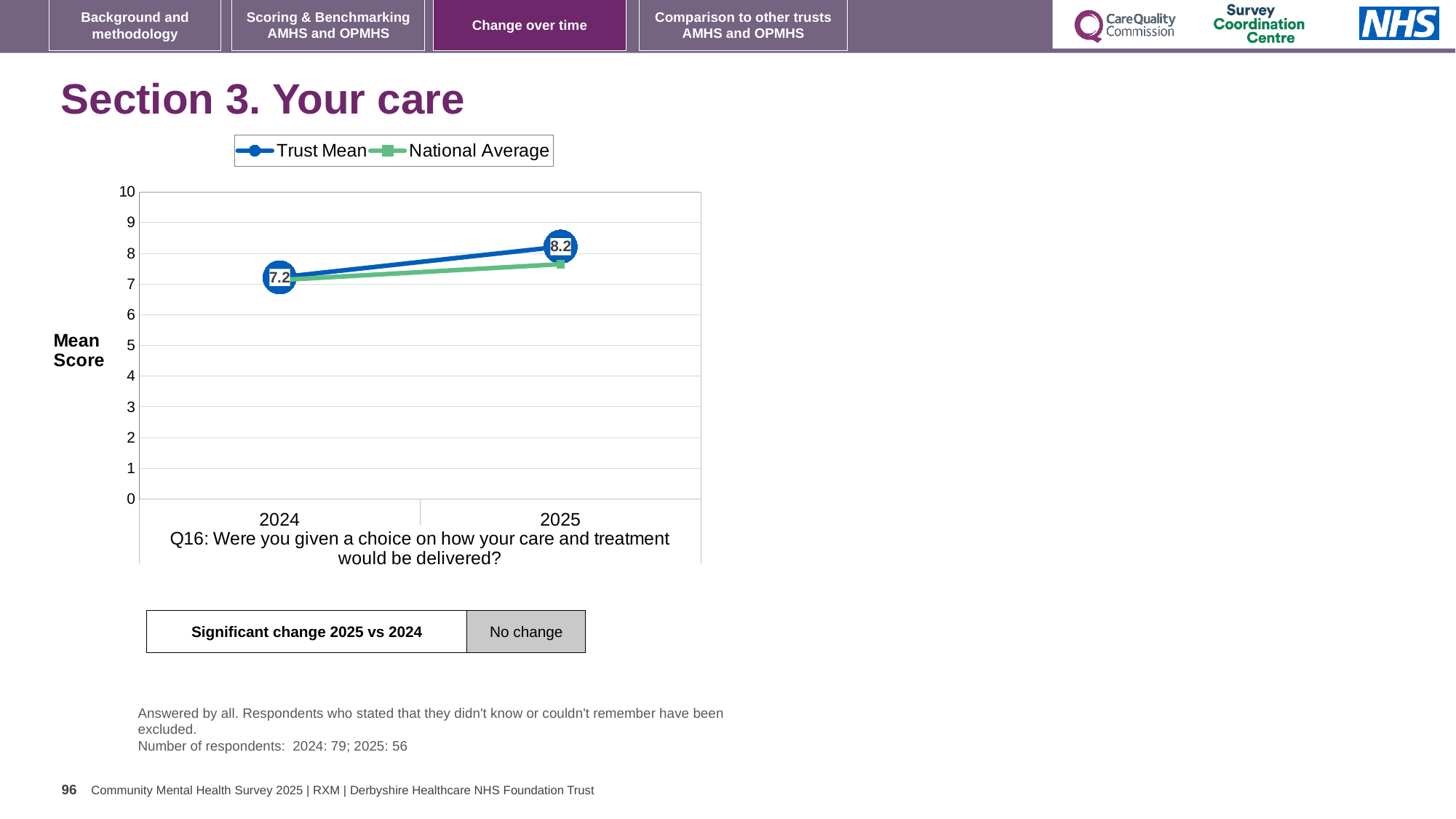
In 2025, which is larger: the Trust Mean or the National Average? Trust Mean By how much did the Trust Mean change from 2024 to 2025? 1.0 How many years are plotted on the x axis? 2 In which year is the Trust Mean highest? 2025 In which year is the Trust Mean lowest? 2024 What kind of chart is shown on the slide? line chart Is the National Average value for 2025 greater or less than 8? less What is the Trust Mean value for 2024? 7.2 Does the Trust Mean rise or fall from 2024 to 2025? rise What is the Trust Mean value for 2025? 8.2 How many series does the legend list? 2 What is the label on the y axis of the chart? Mean Score